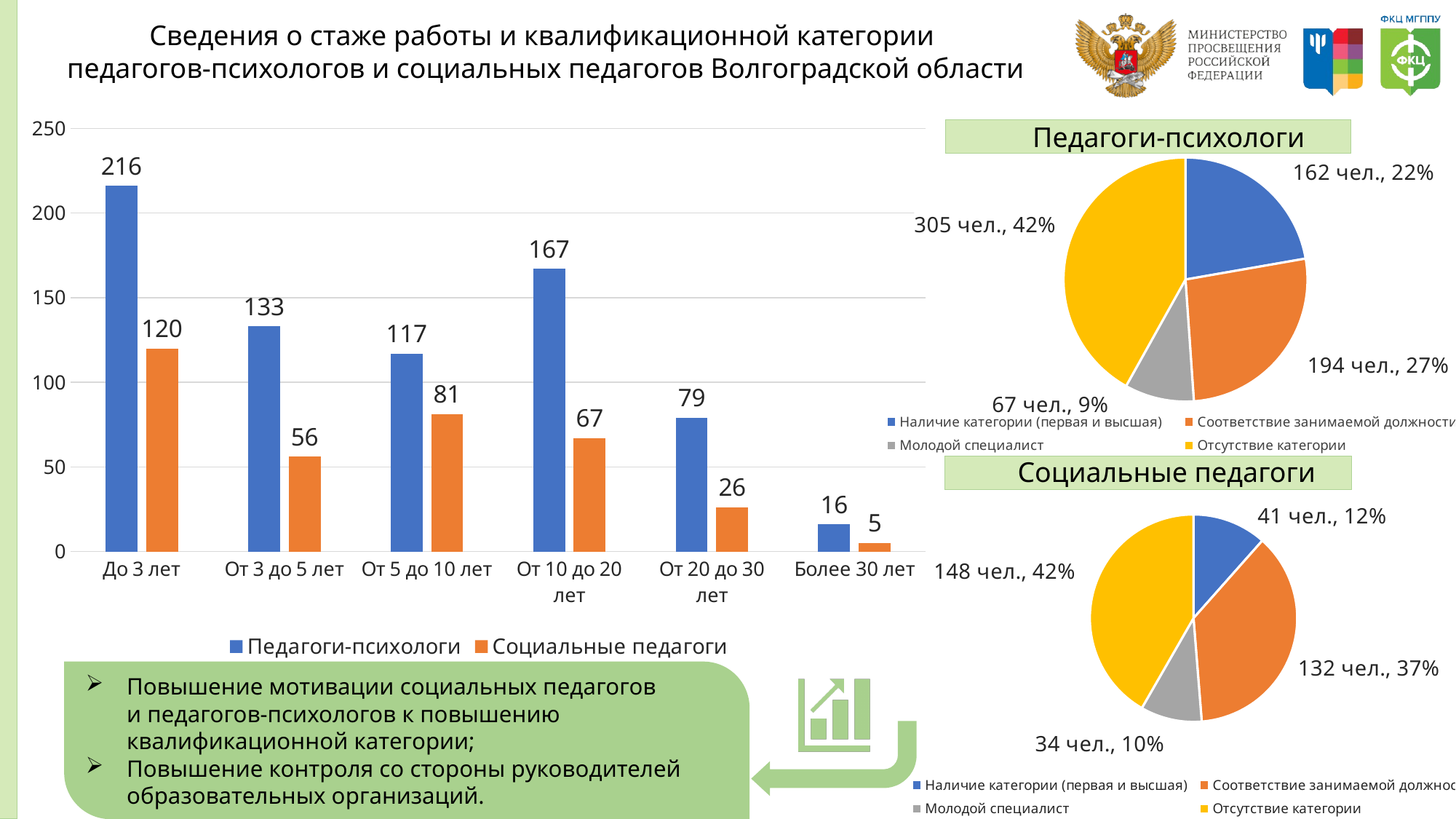
In the bar chart on the left, what is the difference between Педагоги-психологи and Социальные педагоги in the category От 10 до 20 лет? 100 What kind of chart is the chart on the left of the slide? Bar chart In the pie chart titled Педагоги-психологи, how many people are in the slice Молодой специалист? 67 чел. In the bar chart on the left, what is the value for Социальные педагоги in the category От 5 до 10 лет? 81 In the pie chart titled Социальные педагоги, what share does the slice Соответствие занимаемой должности have? 37% In the bar chart on the left, which is larger: Педагоги-психологи in От 3 до 5 лет or Педагоги-психологи in От 5 до 10 лет? От 3 до 5 лет In the bar chart on the left, what is the value for Педагоги-психологи in the category До 3 лет? 216 In the pie chart titled Педагоги-психологи, what share does the slice Отсутствие категории have? 42% In the pie chart titled Социальные педагоги, which slice is the largest? Отсутствие категории How many categories are shown on the x axis of the bar chart on the left? 6 In the bar chart on the left, which category has the lowest value for Педагоги-психологи? Более 30 лет How many series does the legend of the bar chart on the left list? 2